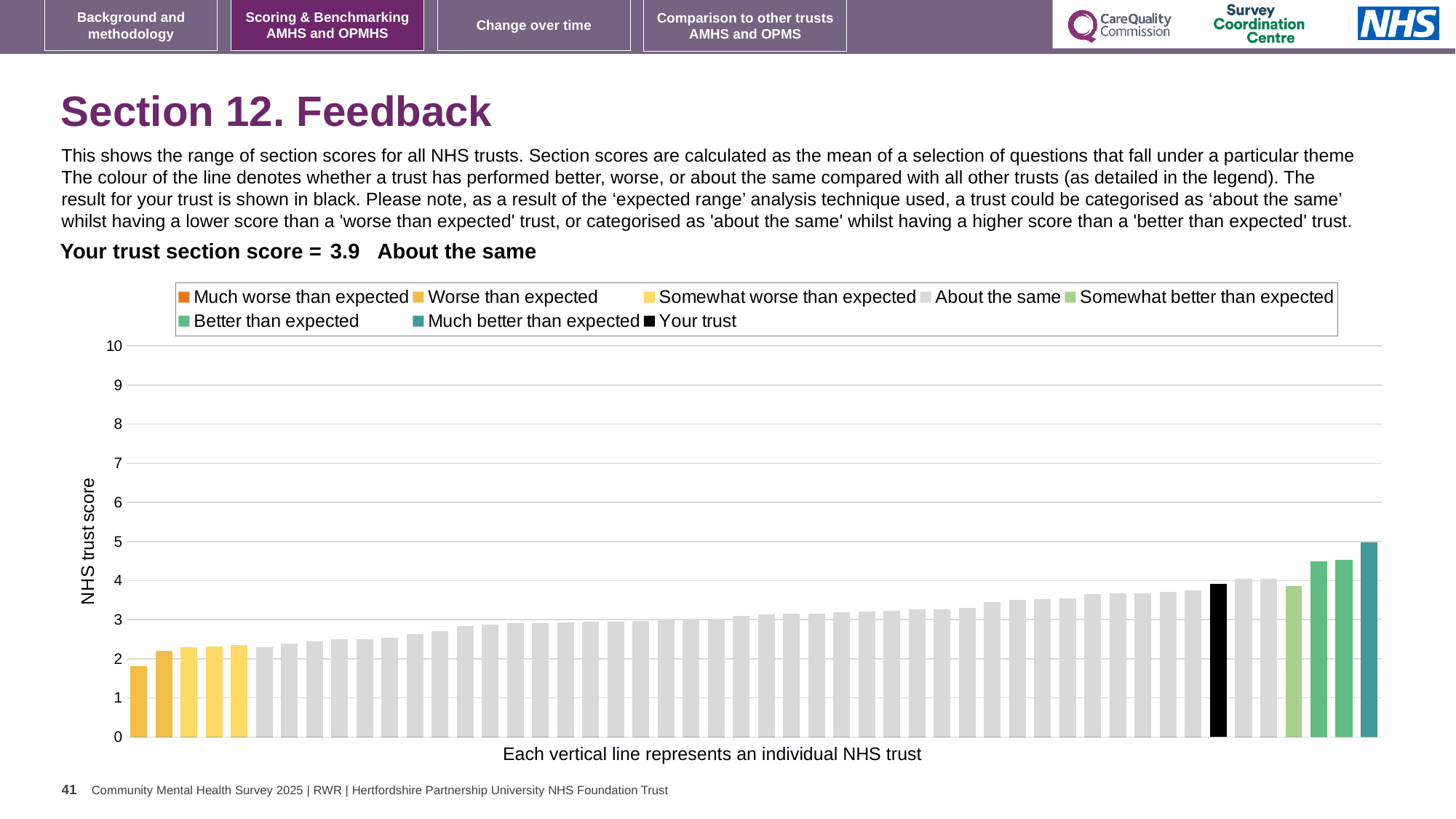
What colour is used for the 'Your trust' bar according to the legend? black Is the value for your trust greater or less than 3? greater What is the label on the vertical axis of the chart? NHS trust score Do the bar values rise or fall from left to right along the x axis? rise Which category is your trust's section score placed in? About the same How many entries does the chart legend list? 8 Is your trust's bar higher or lower than the lowest bar on the chart? higher What kind of chart is shown on the slide? bar chart What is your trust's section score shown on the slide? 3.9 Which legend category does the highest bar belong to? Much better than expected Is the value for the highest bar greater or less than 4? greater Is the value for the lowest bar greater or less than 2? less